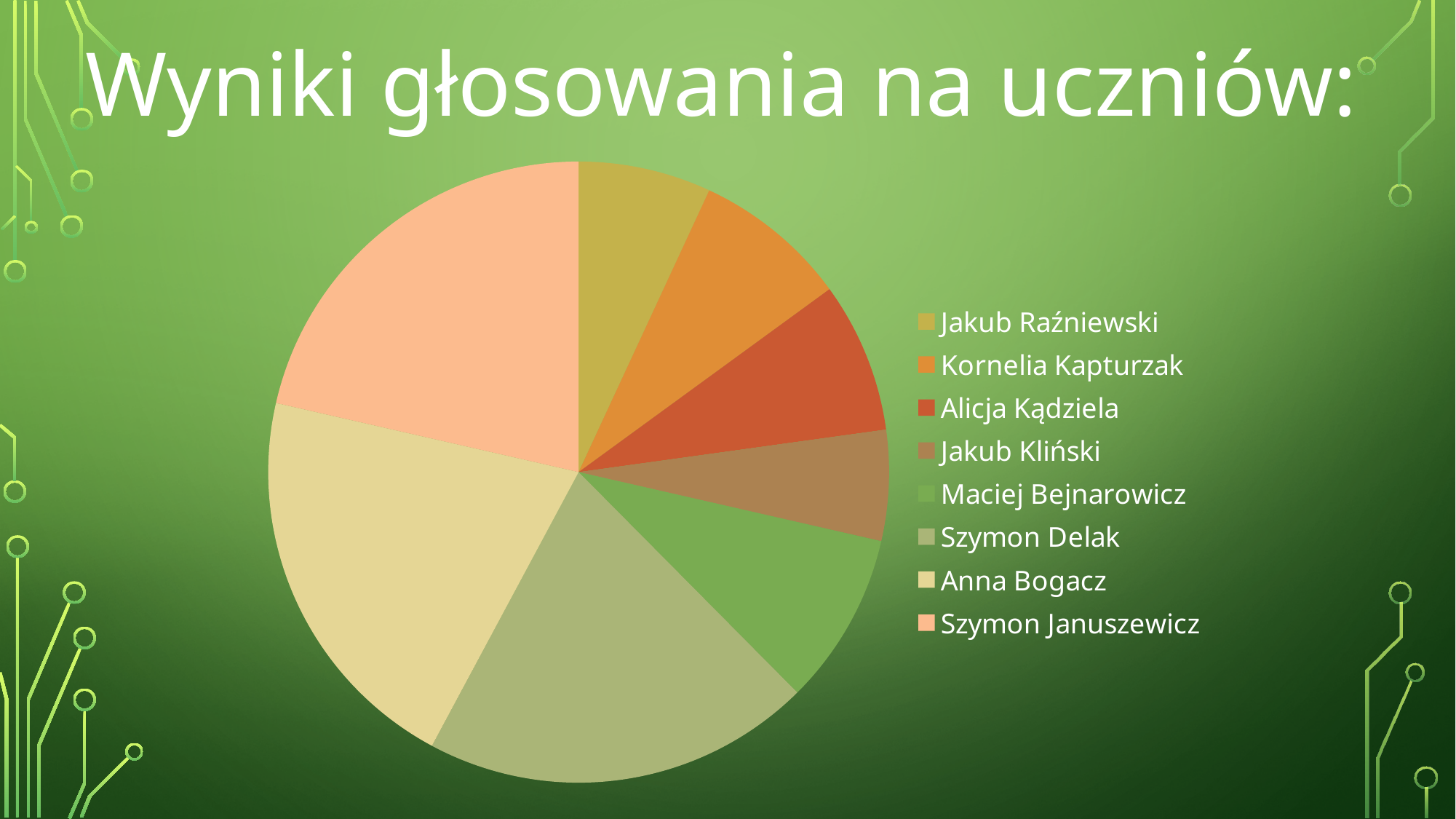
Which legend entry is shown in the last position of the pie chart's legend? Szymon Januszewicz Which slice is larger, Szymon Delak or Jakub Kliński? Szymon Delak Which slice is larger, Maciej Bejnarowicz or Szymon Delak? Szymon Delak What kind of chart is shown on the slide? pie chart Which slice is larger, Anna Bogacz or Kornelia Kapturzak? Anna Bogacz What is the title of the slide containing the pie chart? Wyniki głosowania na uczniów: How many entries does the legend of the pie chart list? 8 How many slices does the pie chart have? 8